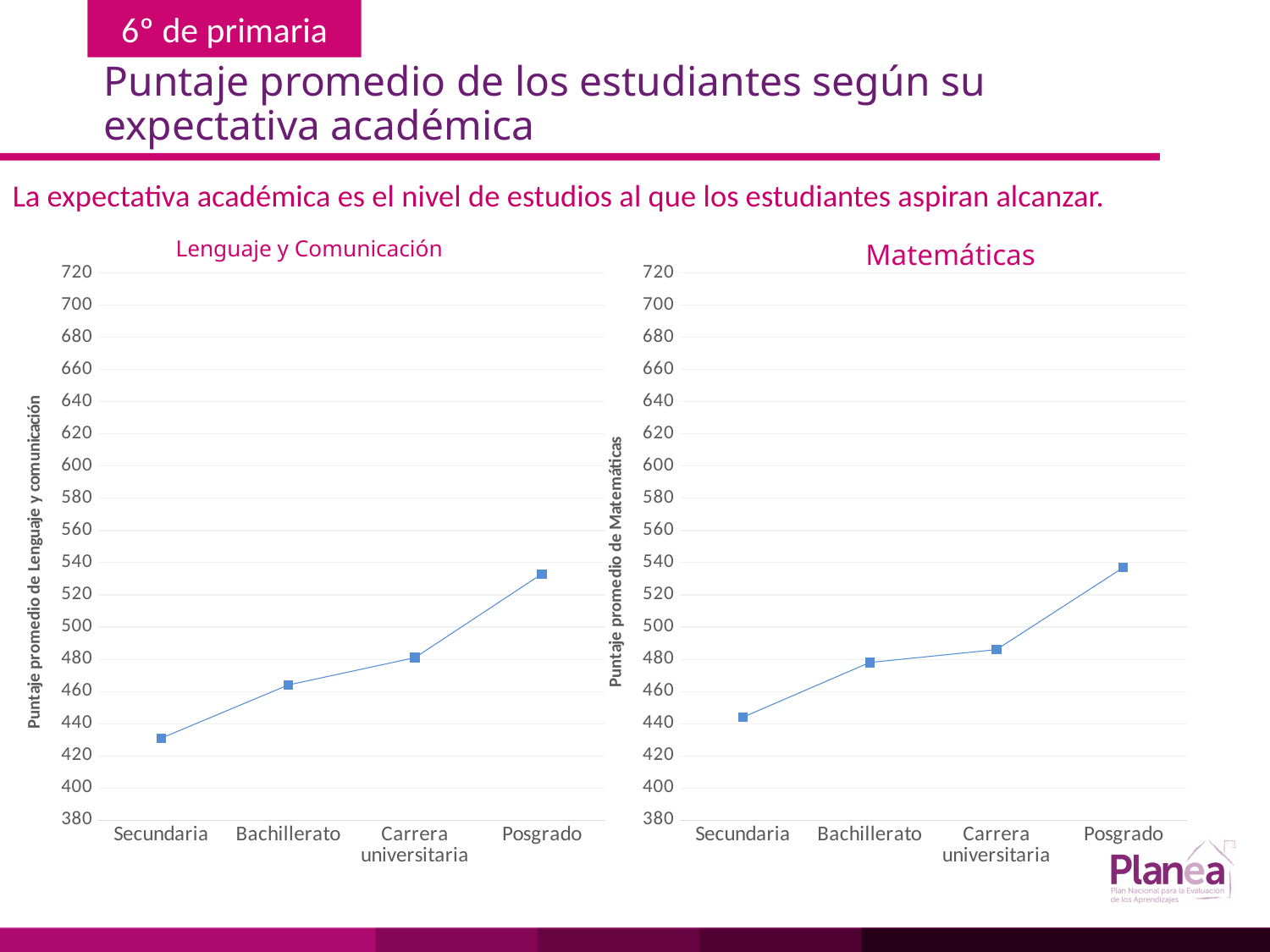
What is the y-axis label of the 'Matemáticas' chart? Puntaje promedio de Matemáticas In the 'Matemáticas' chart, which category has the highest score? Posgrado In the 'Lenguaje y Comunicación' chart, how many categories are shown on the x axis? 4 In the 'Matemáticas' chart, which is larger, the value for Secundaria or the value for Carrera universitaria? Carrera universitaria In the 'Lenguaje y Comunicación' chart, do the values rise or fall from Secundaria to Posgrado? rise In the 'Matemáticas' chart, which category has the lowest score? Secundaria What kind of chart is the 'Lenguaje y Comunicación' chart? line chart In the 'Lenguaje y Comunicación' chart, which category has the lowest score? Secundaria In the 'Lenguaje y Comunicación' chart, is the value for Posgrado greater or less than 520? greater In the 'Lenguaje y Comunicación' chart, is the value for Secundaria greater or less than 440? less In the 'Lenguaje y Comunicación' chart, which category has the highest score? Posgrado In the 'Matemáticas' chart, is the value for Bachillerato greater or less than 460? greater